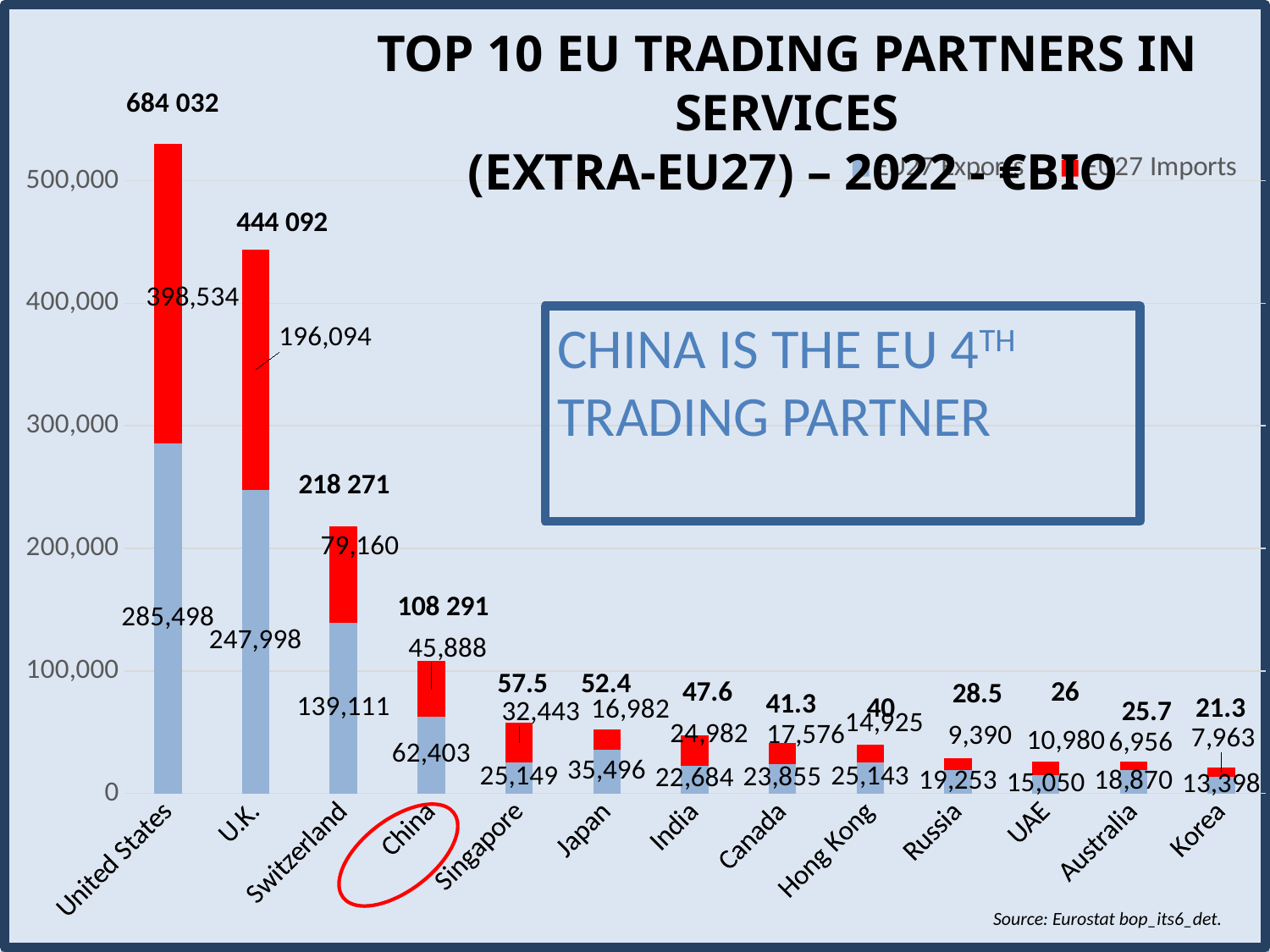
What kind of chart is shown on the slide? Stacked bar chart What is the EU27 Imports (red segment) value for the United States? 398,534 Is the total bar for the U.K. greater or less than 400,000? greater What is the total value labelled above the United States bar? 684 032 What is the difference between the red (imports) and blue (exports) segments for the United States? 113,036 Which trading partner has the highest total bar? United States Which has the larger blue (exports) segment, Japan or Singapore? Japan How many trading partners (categories) are plotted on the x axis? 13 What source is cited at the bottom of the chart? Eurostat bop_its6_det. What is the total value labelled above the Switzerland bar? 218 271 How many series does the legend list? 2 What is the EU27 Exports (blue segment) value for China? 62,403